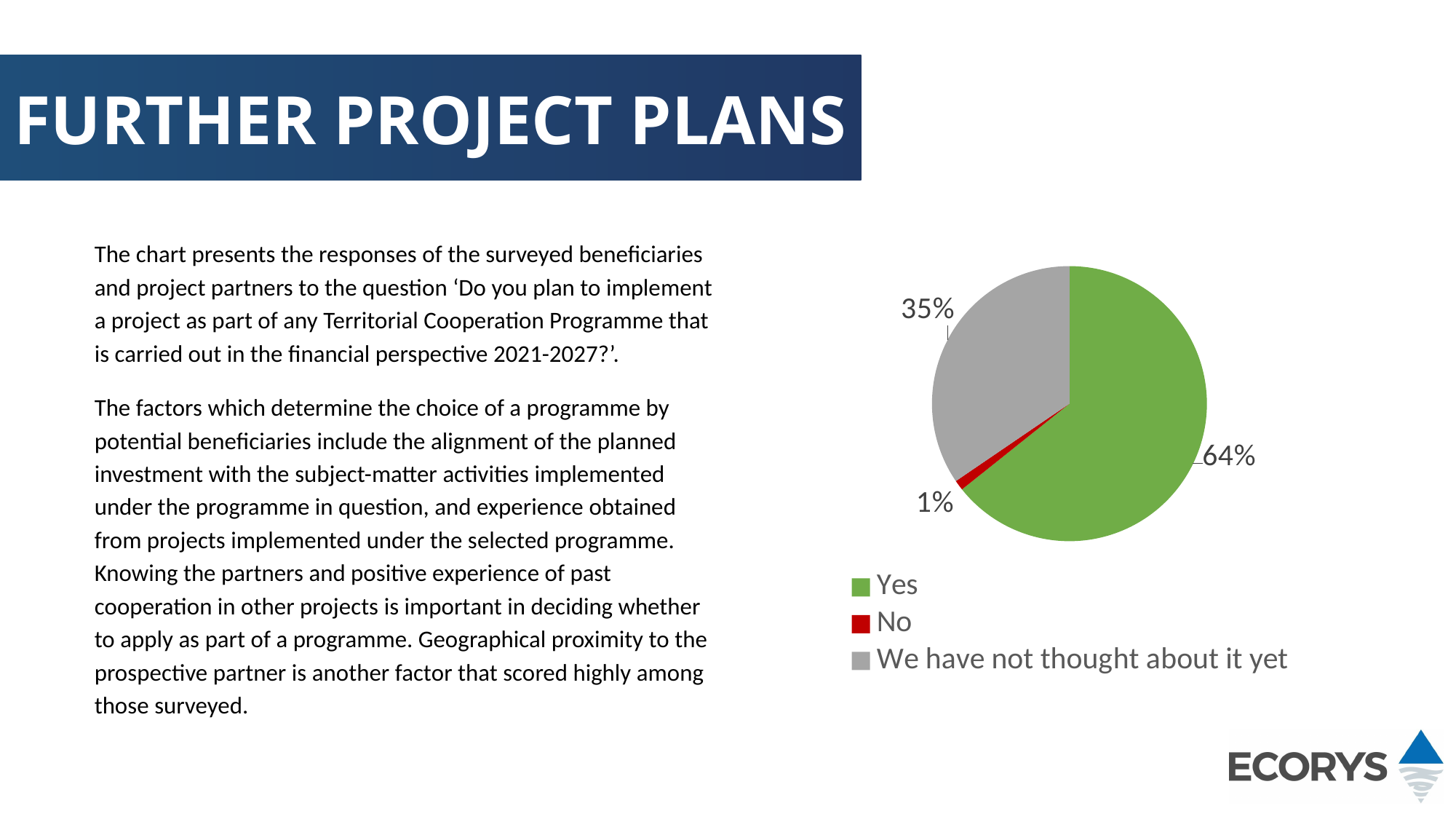
Which response has the largest share of the pie? Yes Which is larger: the share for 'Yes' or the share for 'We have not thought about it yet'? Yes How many slices does the pie chart have? 3 What kind of chart is shown on the slide? pie chart What is the difference in percentage points between 'Yes' and 'We have not thought about it yet'? 29 Which response has the smallest share of the pie? No How many entries does the legend list? 3 What percentage of respondents answered 'No'? 1% What percentage of respondents answered 'Yes'? 64% What colour is the 'We have not thought about it yet' slice? grey What percentage of respondents answered 'We have not thought about it yet'? 35% What colour is the 'No' slice in the pie chart? red